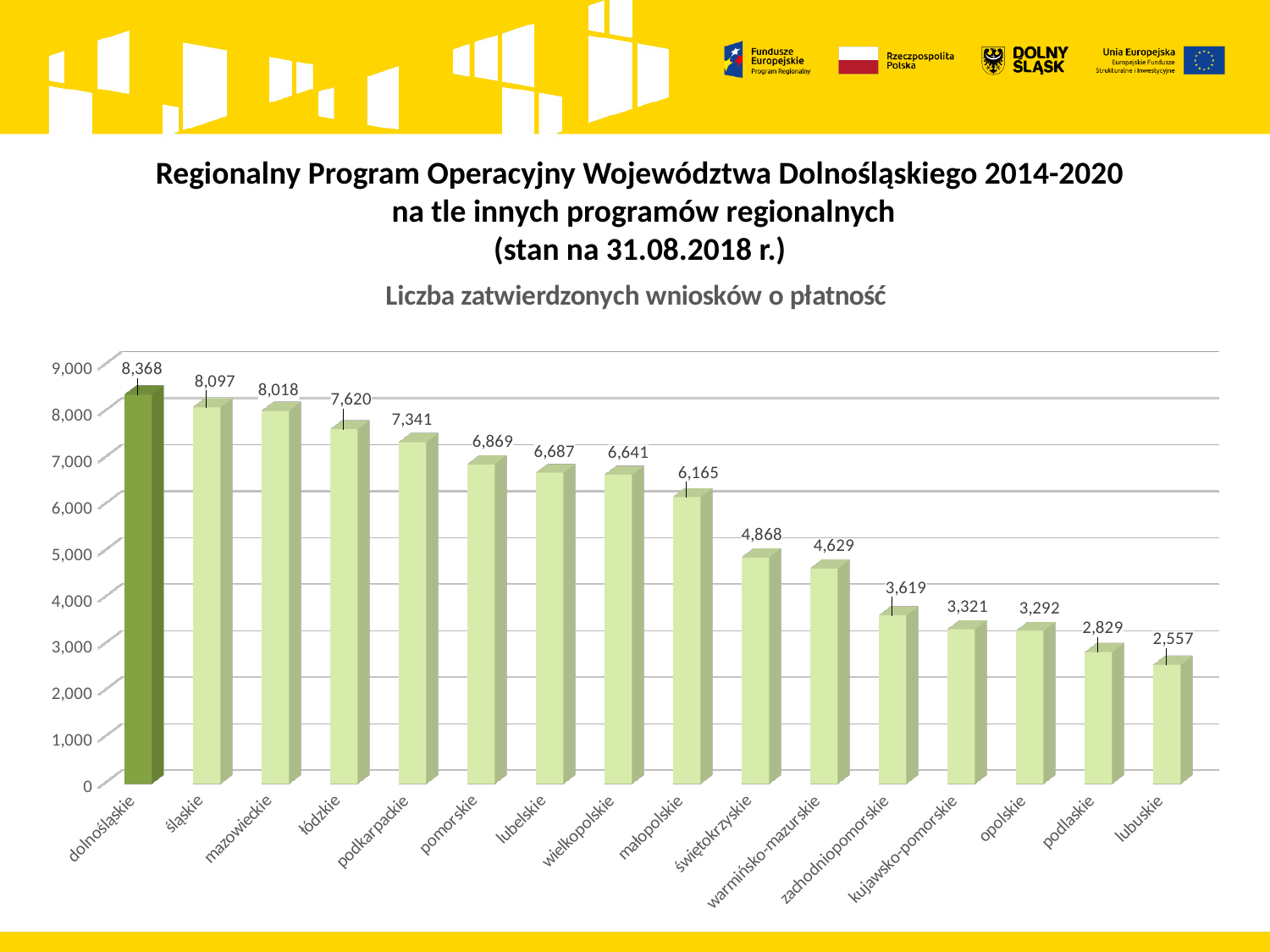
What is the difference between the values for dolnośląskie and śląskie? 271 What is the value for dolnośląskie? 8,368 How many categories are shown on the x axis? 16 What is the difference between the values for świętokrzyskie and warmińsko-mazurskie? 239 Do the values rise or fall from left to right along the x axis? fall Is the value for podkarpackie greater or less than 7,000? greater Which category has the lowest value? lubuskie Which is larger, the value for pomorskie or the value for lubelskie? pomorskie What kind of chart is shown on the slide? bar chart What is the value for małopolskie? 6,165 What is the value for zachodniopomorskie? 3,619 Which category has the highest value? dolnośląskie